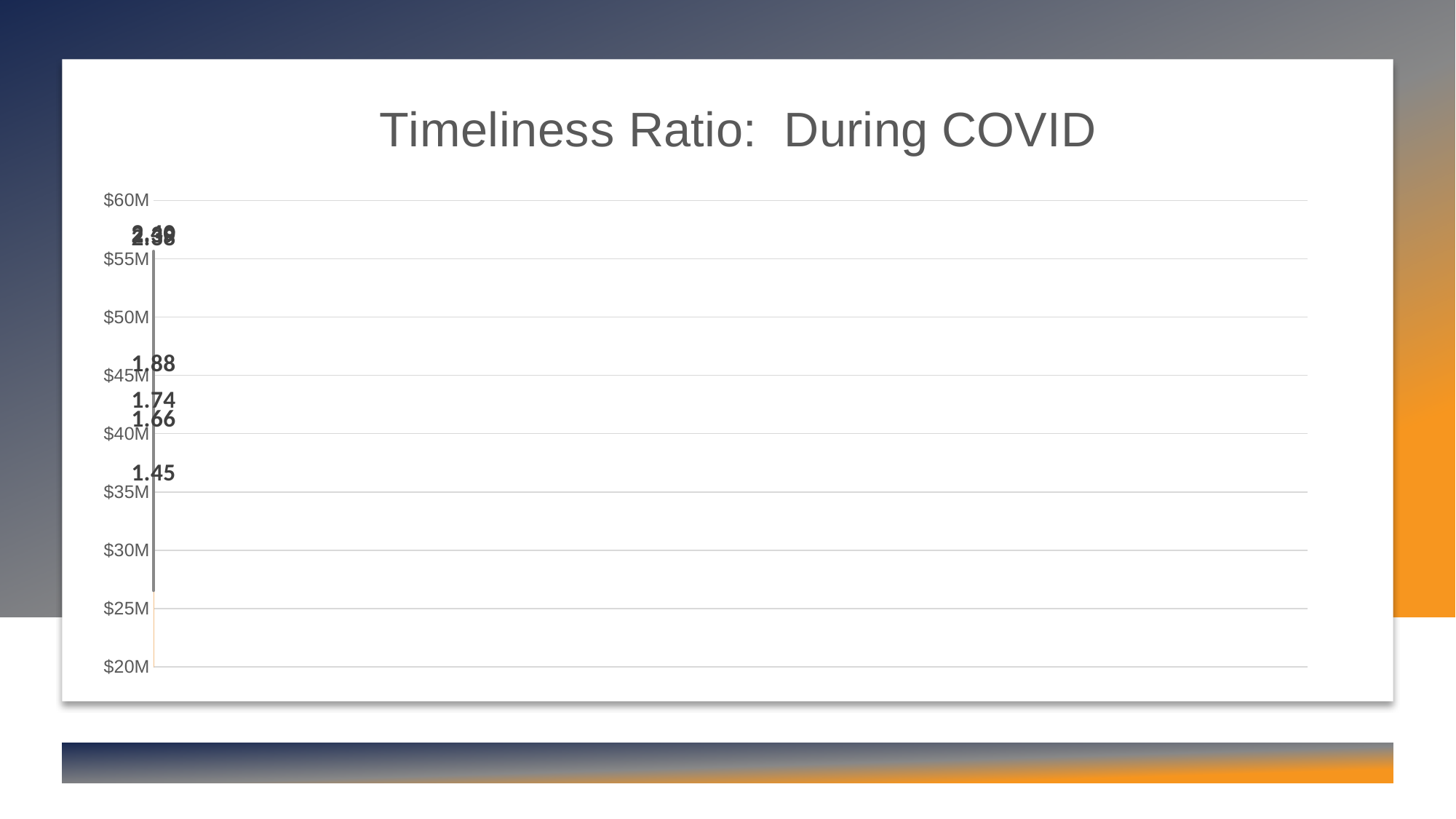
What is the title of the chart? Timeliness Ratio: During COVID What is the highest value shown on the chart's vertical axis? $60M What is the lowest readable data label on the chart? 1.45 What is the difference between the data labels 1.88 and 1.45? 0.43 Which readable data label is larger, 1.74 or 1.66? 1.74